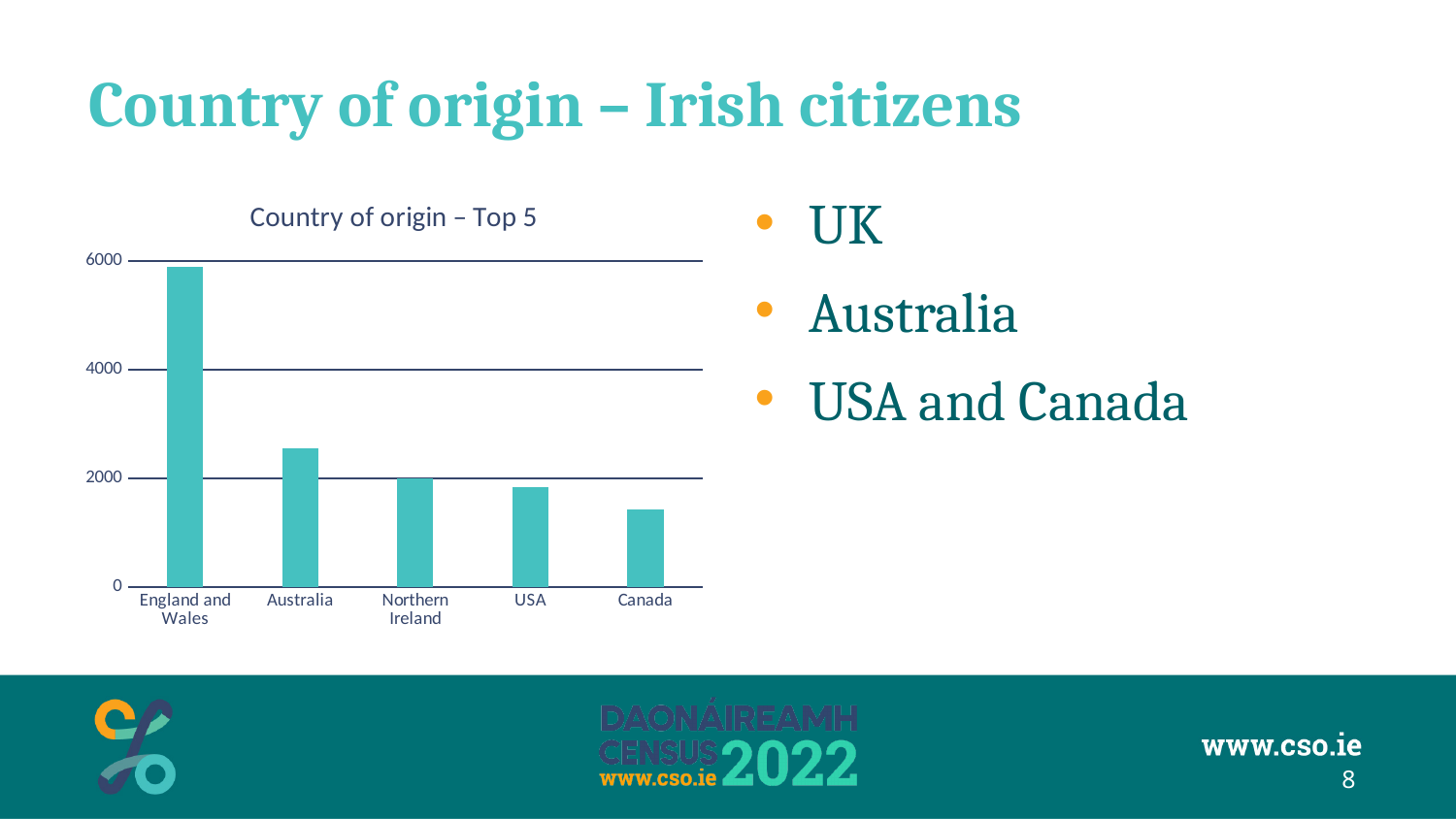
Is the value for Canada greater or less than 2000? less Which country has the lowest value in the chart? Canada Which country has the highest value in the chart? England and Wales Is the value for Australia greater or less than 2000? greater Do the values rise or fall from left to right across the chart? fall What kind of chart is shown on the slide? bar chart Which has a larger value, USA or Canada? USA Which has a larger value, Australia or Northern Ireland? Australia What is the title of the chart? Country of origin – Top 5 How many countries are shown in the chart? 5 Is the value for England and Wales greater or less than 4000? greater What colour are the bars in the chart? teal